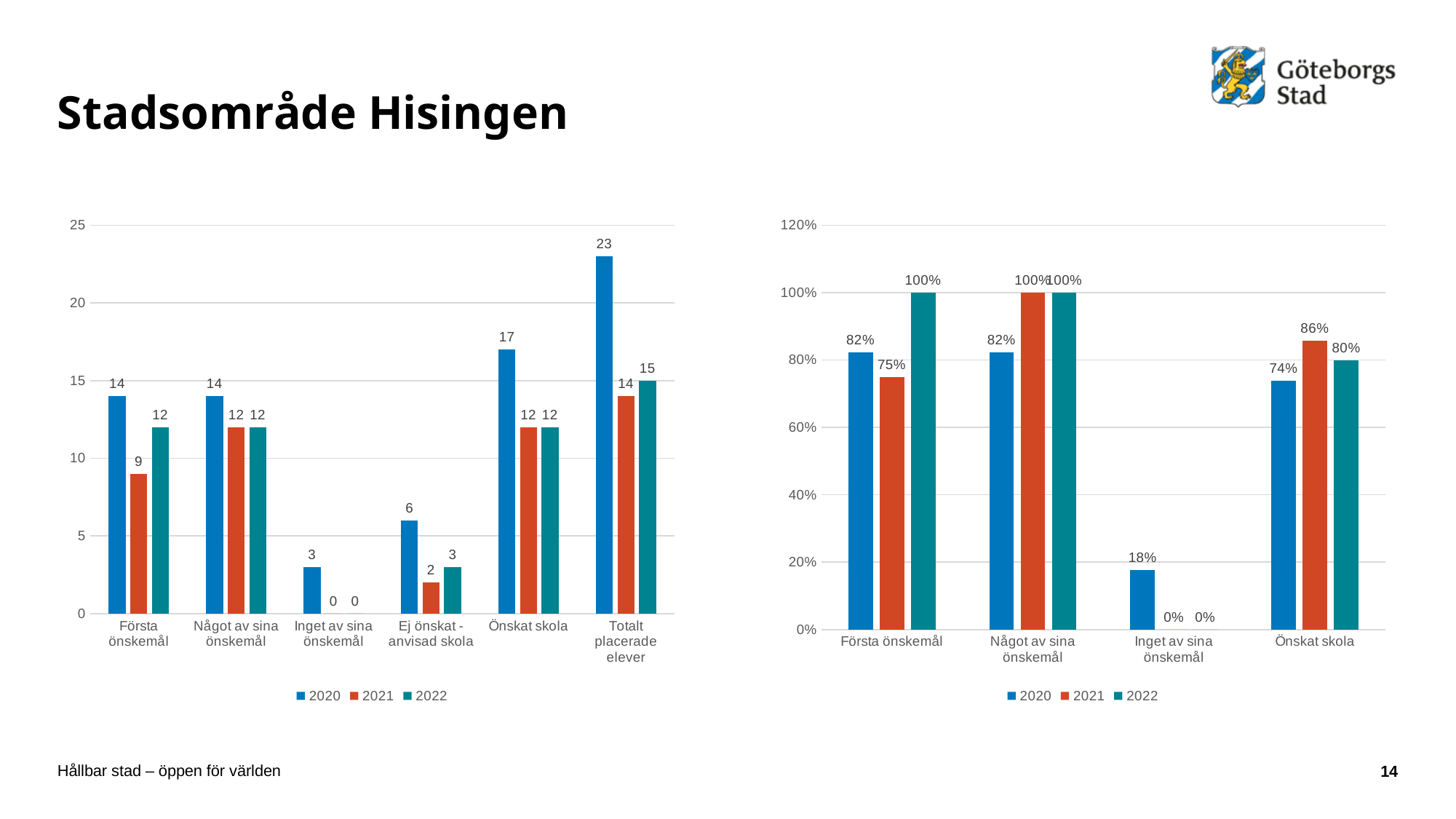
What kind of chart is the right chart? Bar chart In the left chart, which category has the highest value for the 2020 series? Totalt placerade elever In the left chart, what is the value for 2021 in the 'Första önskemål' category? 9 In the right chart, which is larger for 'Första önskemål': the 2021 value or the 2022 value? 2022 In the right chart, what is the value for 2021 in the 'Önskat skola' category? 86% In the left chart, how many categories are shown on the x axis? 6 In the left chart, how many series does the legend list? 3 In the right chart, how many categories are shown on the x axis? 4 In the right chart, what is the difference between the 2020 and 2021 values for 'Första önskemål'? 7% In the right chart, what is the value for 2020 in the 'Inget av sina önskemål' category? 18% In the left chart, what is the value for 2020 in the 'Totalt placerade elever' category? 23 In the left chart, what is the difference between the 2020 and 2022 values for 'Totalt placerade elever'? 8